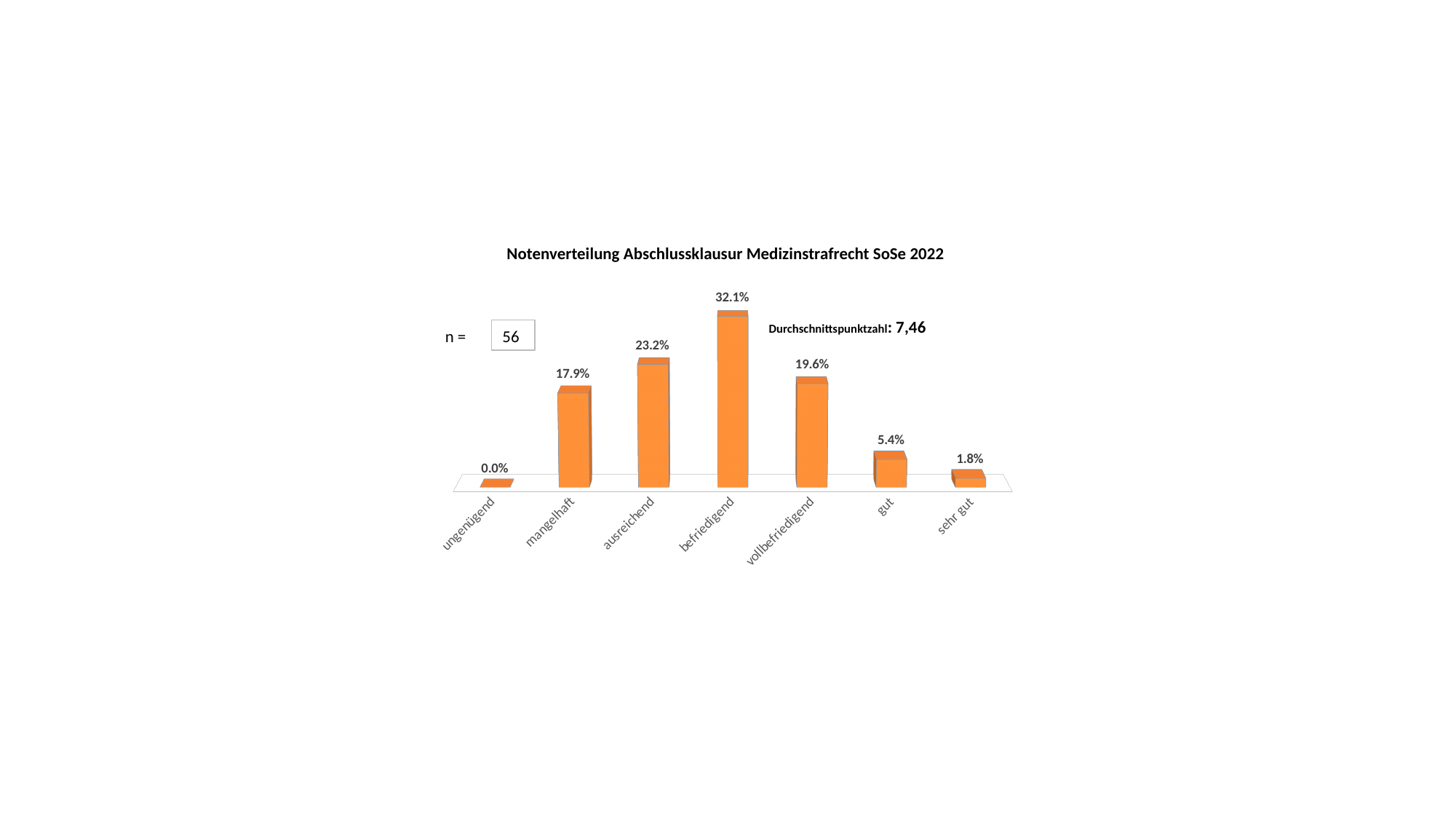
What is the value for sehr gut? 1.8% How many categories are shown on the x axis? 7 What is the value of n shown next to the chart? 56 What is the value for mangelhaft? 17.9% What is the difference between the values for befriedigend and ausreichend? 8.9% What kind of chart is shown on the slide? bar chart Which is larger, the value for ausreichend or the value for vollbefriedigend? ausreichend Which category has the highest value? befriedigend What is the value for befriedigend? 32.1% Which category has the lowest value? ungenügend What is the title of the chart? Notenverteilung Abschlussklausur Medizinstrafrecht SoSe 2022 What is the value for vollbefriedigend? 19.6%